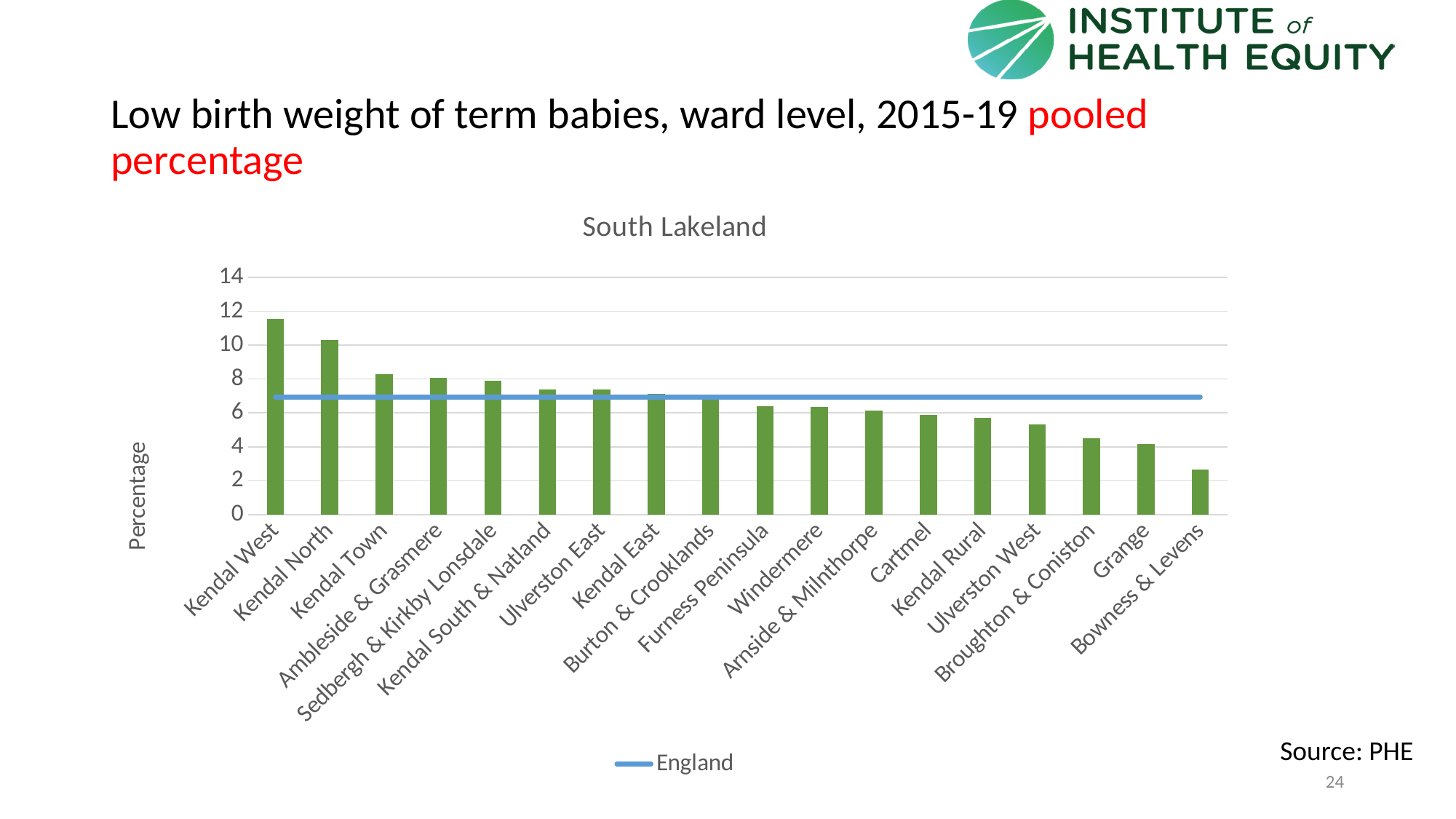
Which has the larger value, Windermere or Grange? Windermere What kind of chart is shown on the slide? Bar chart Is the value for Bowness & Levens greater or less than 4? less Which ward has the lowest value in the South Lakeland chart? Bowness & Levens Do the bar values rise or fall moving from left to right along the x axis? Fall Which ward has the highest value in the South Lakeland chart? Kendal West Is the value for Kendal West greater or less than 10? greater Which has the larger value, Kendal North or Kendal Town? Kendal North How many wards are plotted as bars in the chart? 18 Is the value for Grange greater or less than 6? less What is the title shown above the chart? South Lakeland What does the blue horizontal line in the chart represent, according to the legend? England